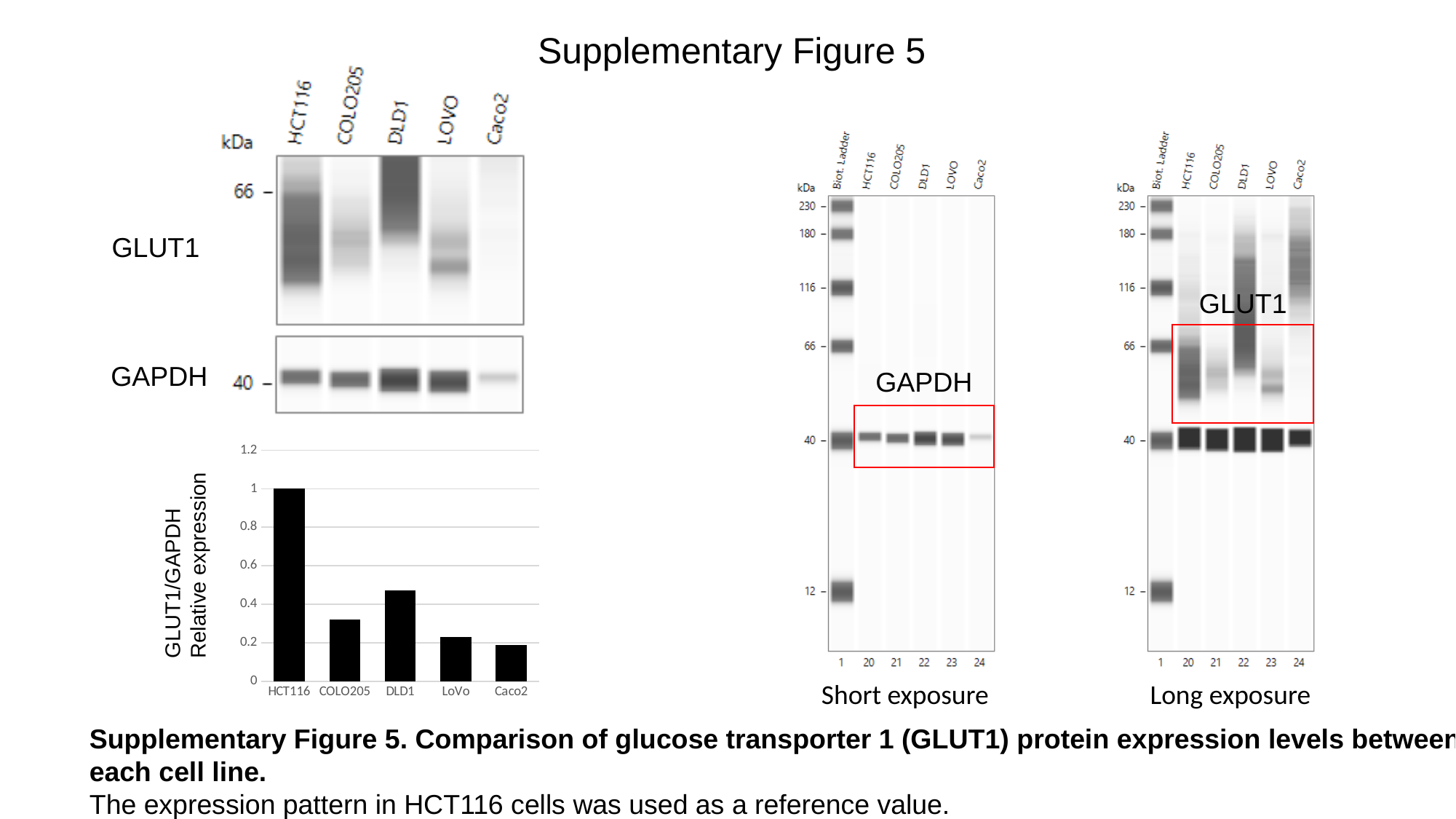
In the bar chart, which has the larger GLUT1/GAPDH relative expression, DLD1 or COLO205? DLD1 In the bar chart, is the value for DLD1 greater or less than 0.4? greater In the bar chart, what is the GLUT1/GAPDH relative expression value for HCT116? 1 In the bar chart, is the value for COLO205 greater or less than 0.4? less In the bar chart, how many cell lines are plotted on the x axis? 5 In the bar chart, which cell line has the highest GLUT1/GAPDH relative expression? HCT116 In the bar chart, is the value for LoVo greater or less than 0.2? greater What kind of chart is shown at the bottom left of the slide? bar chart In the bar chart, which cell line has the lowest GLUT1/GAPDH relative expression? Caco2 In the bar chart, which has the larger GLUT1/GAPDH relative expression, LoVo or HCT116? HCT116 What is the y-axis label of the bar chart? GLUT1/GAPDH Relative expression